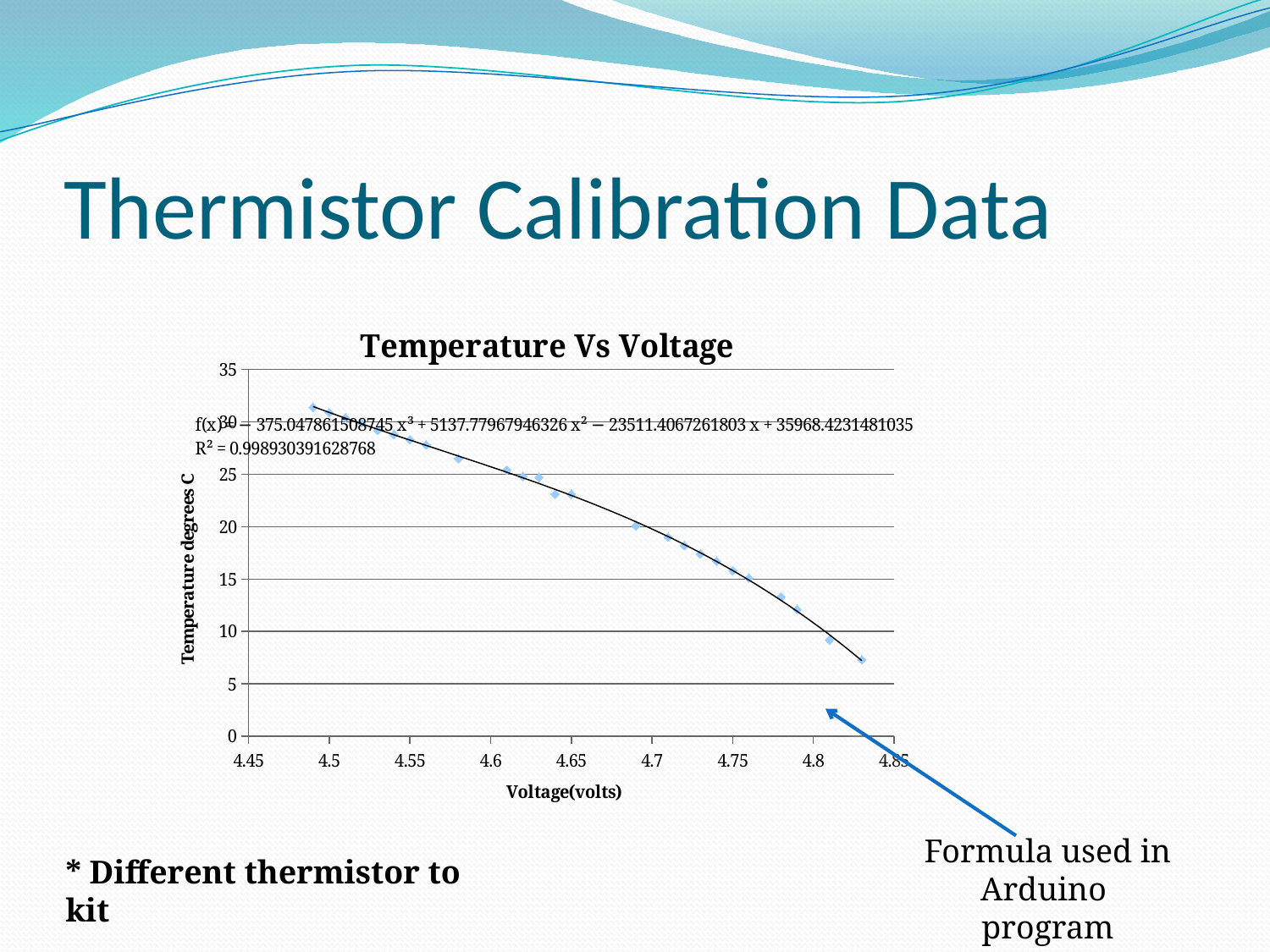
Is the temperature at the rightmost data point (about 4.83 volts) greater or less than 10? less Is the temperature at the leftmost data point (about 4.49 volts) greater or less than 30? greater Do the temperature values rise or fall as voltage increases along the x axis? fall What kind of chart is shown on the slide? scatter chart Is the temperature at about 4.55 volts greater or less than 25? greater Which has the higher temperature, the leftmost data point or the rightmost data point? the leftmost data point What is the title of the chart? Temperature Vs Voltage What R² value is printed on the chart for the fitted curve? R² = 0.998930391628768